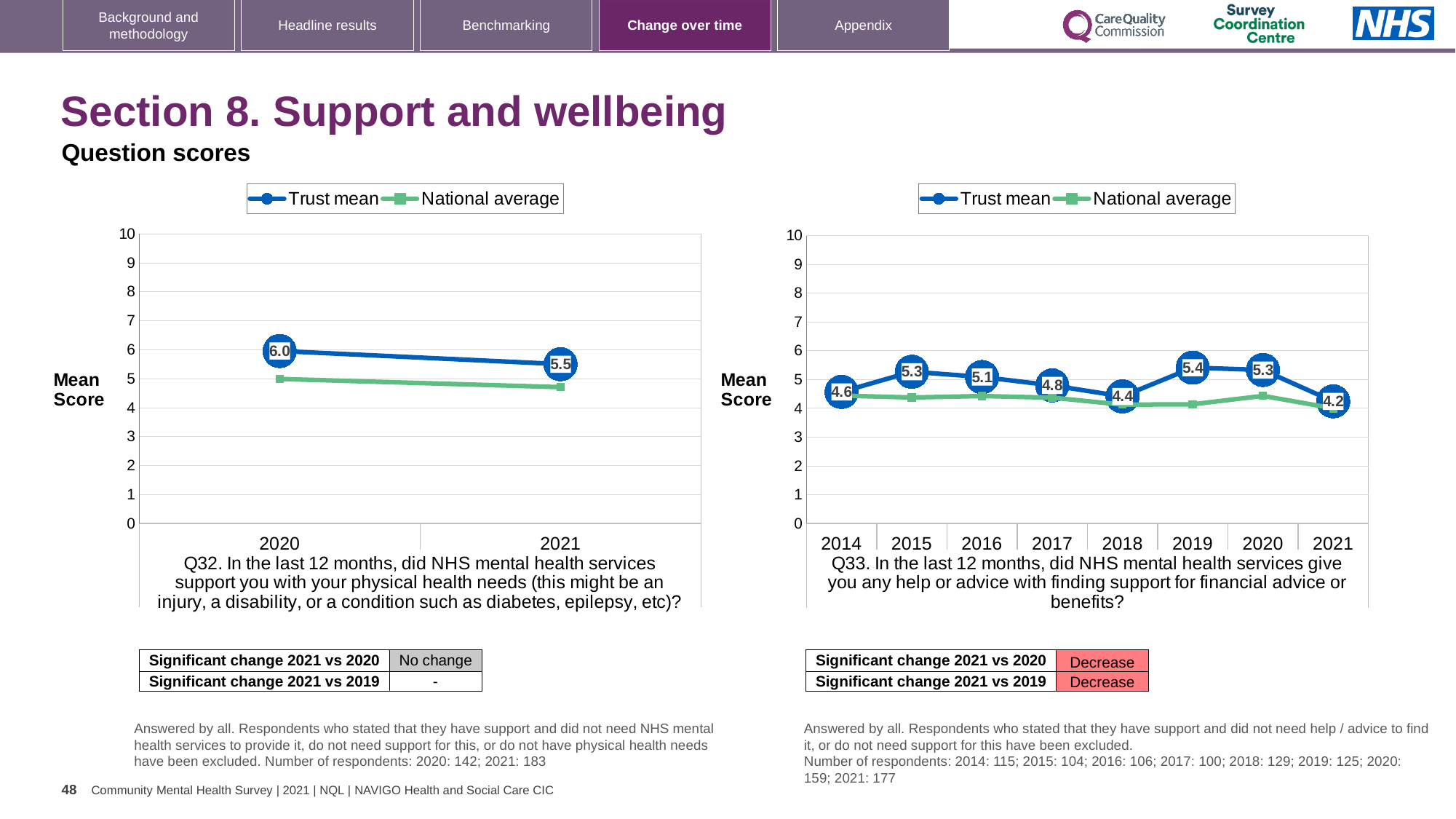
In the Q32 chart on the left, is the National average for 2020 greater or less than 6? less In the Q33 chart on the right, what is the Trust mean for 2014? 4.6 What type of chart is the Q32 chart on the left? Line chart How many series does the legend of the Q33 chart on the right list? 2 In the Q32 chart on the left, what is the Trust mean for 2020? 6.0 In the Q32 chart on the left, by how much did the Trust mean fall from 2020 to 2021? 0.5 In the Q33 chart on the right, which year has the lowest Trust mean? 2021 In the Q33 chart on the right, what is the difference between the Trust mean in 2019 and in 2021? 1.2 In the Q33 chart on the right, what is the Trust mean for 2019? 5.4 In the Q33 chart on the right, which year has the highest Trust mean? 2019 In the Q33 chart on the right, how many years are shown on the x axis? 8 In the Q32 chart on the left, what is the Trust mean for 2021? 5.5